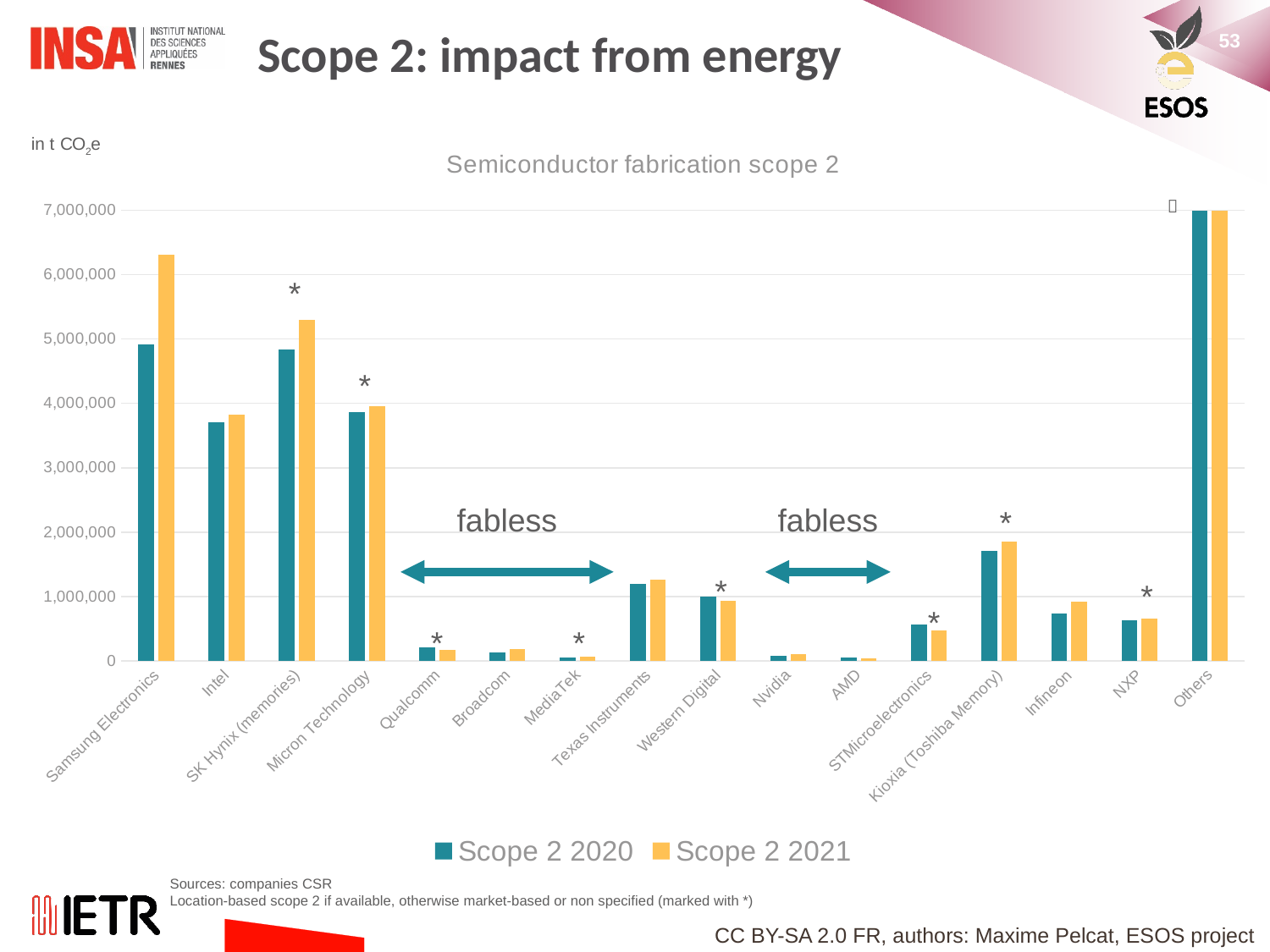
Among the named companies (excluding Others), which has the highest Scope 2 2021 value? Samsung Electronics Which colour represents the Scope 2 2021 series? yellow/orange What is the title of the chart? Semiconductor fabrication scope 2 Is the Scope 2 2021 value for Kioxia (Toshiba Memory) greater or less than 2,000,000? less What kind of chart is shown on the slide? bar chart Which is larger: the Scope 2 2021 value for Samsung Electronics or for SK Hynix (memories)? Samsung Electronics How many series does the legend list? 2 Is the Scope 2 2021 value for Samsung Electronics greater or less than 6,000,000? greater How many companies/categories are shown on the x axis? 16 Is the Scope 2 2021 value for Texas Instruments greater or less than 1,000,000? greater Which category has the highest Scope 2 2021 value? Others